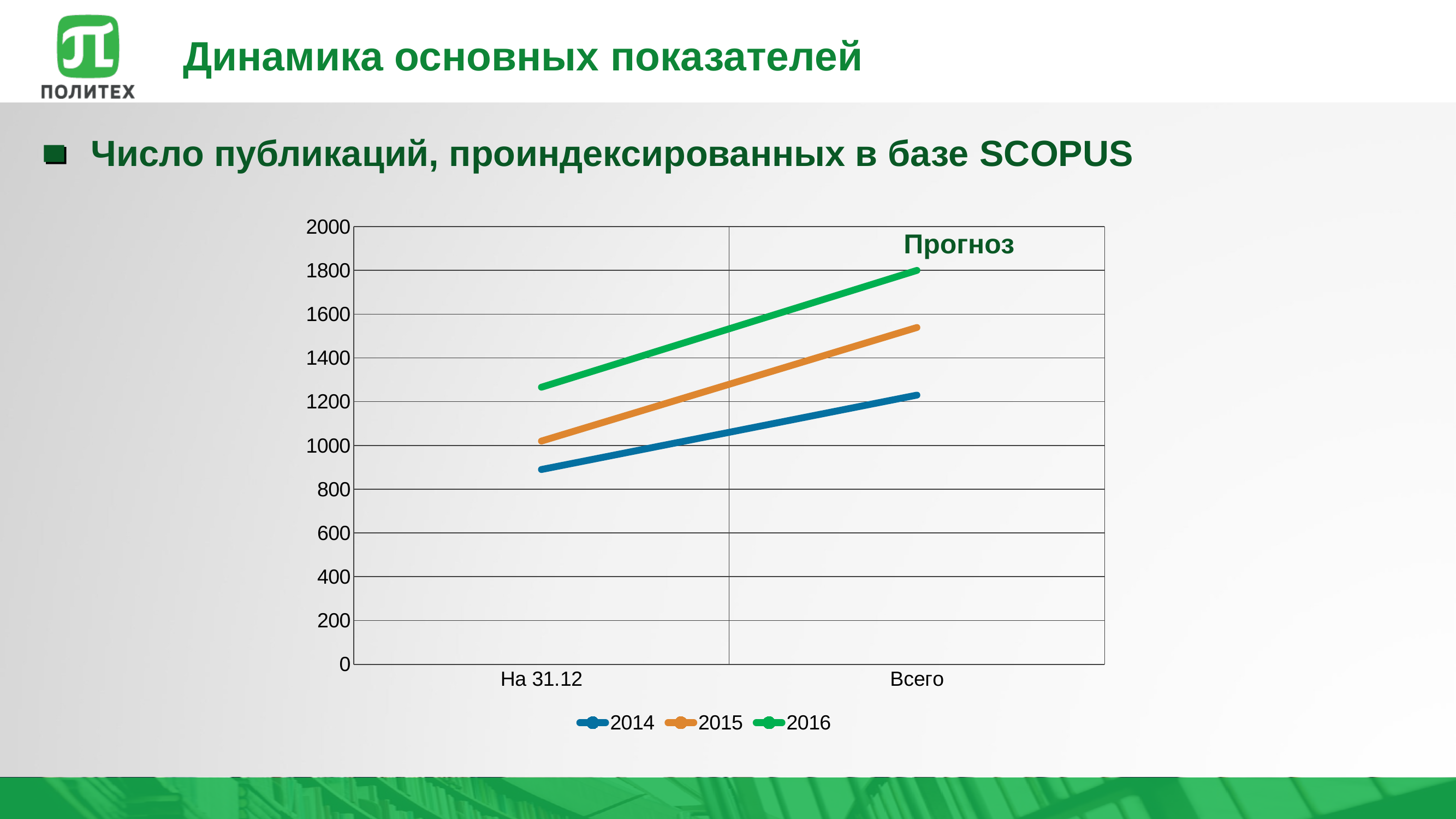
Is the value for 2014 at "На 31.12" greater or less than 1000? less How many series does the legend list? 3 Which is larger at "Всего": the value for 2015 or the value for 2014? 2015 What word is written inside the plot area above the lines on the right? Прогноз What kind of chart is shown on the slide? line chart How many categories are on the x axis? 2 Do the values for the 2016 series rise or fall from "На 31.12" to "Всего"? rise Which series has the lowest value at "На 31.12"? 2014 Is the value for 2015 at "Всего" greater or less than 1400? greater Which series has the highest value at "Всего"? 2016 Is the value for 2014 at "Всего" greater or less than 1400? less